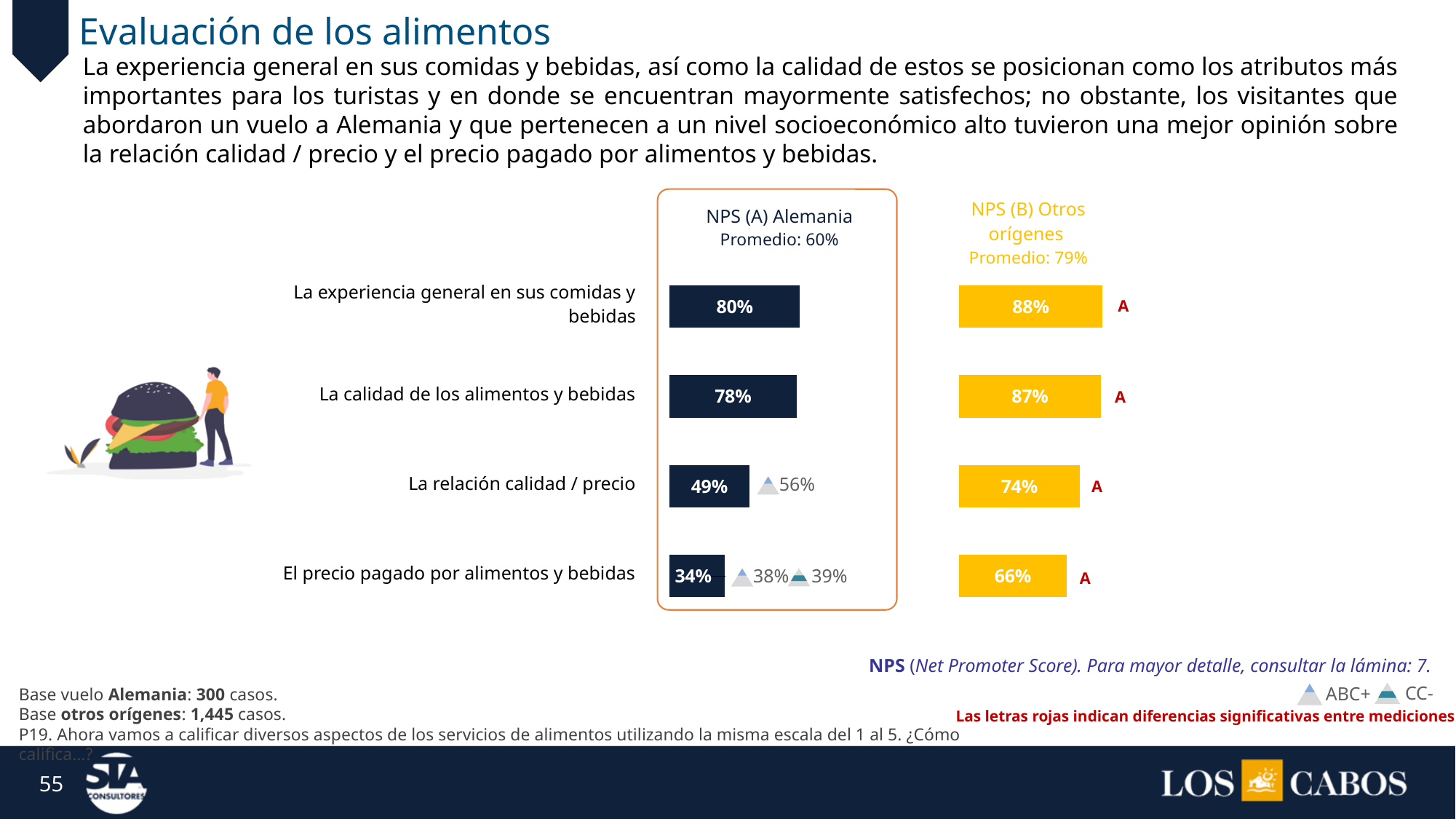
In the NPS (B) Otros orígenes chart, what is the value for 'La relación calidad / precio'? 74% In the NPS (B) Otros orígenes chart, what is the value for 'La calidad de los alimentos y bebidas'? 87% What is the 'Promedio' shown for NPS (B) Otros orígenes? 79% In the NPS (A) Alemania chart, what is the value for 'La experiencia general en sus comidas y bebidas'? 80% How many categories are shown in the NPS (A) Alemania chart? 4 In the NPS (A) Alemania chart, which category has the lowest value? El precio pagado por alimentos y bebidas For 'La calidad de los alimentos y bebidas', which is larger: the NPS (A) Alemania value or the NPS (B) Otros orígenes value? NPS (B) Otros orígenes What is the difference between the NPS (A) Alemania values for 'La experiencia general en sus comidas y bebidas' and 'El precio pagado por alimentos y bebidas'? 46 percentage points In the NPS (B) Otros orígenes chart, which category has the highest value? La experiencia general en sus comidas y bebidas In the NPS (A) Alemania chart, what is the value for 'El precio pagado por alimentos y bebidas'? 34% What is the difference between the NPS (B) Otros orígenes value and the NPS (A) Alemania value for 'La relación calidad / precio'? 25 percentage points What type of chart is used to show the NPS values on this slide? Bar chart